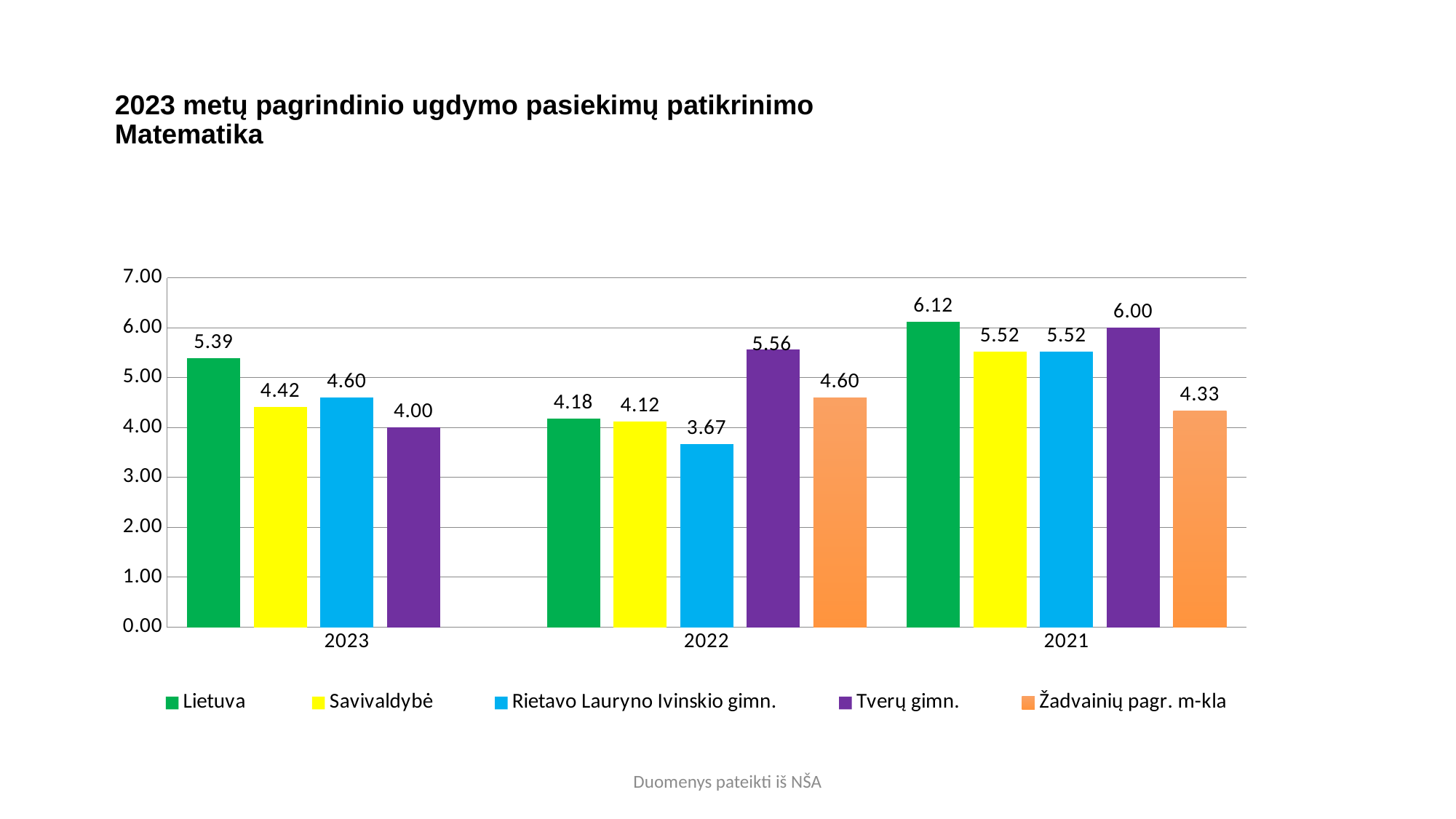
What kind of chart is shown on the slide? bar chart How many year categories are shown on the x axis? 3 What is the difference between the Lietuva values for 2021 and 2023? 0.73 How many series does the legend list? 5 Which series has the highest value in 2021? Lietuva Does the value for Tverų gimn. rise or fall from 2021 to 2023 along the x axis? fall What is the value for Žadvainių pagr. m-kla in 2021? 4.33 Which is larger in 2023: the value for Savivaldybė or the value for Rietavo Lauryno Ivinskio gimn.? Rietavo Lauryno Ivinskio gimn. What is the value for Lietuva in 2023? 5.39 Which series has the lowest value in 2022? Rietavo Lauryno Ivinskio gimn. What is the value for Tverų gimn. in 2022? 5.56 Which series is shown in purple in the legend? Tverų gimn.